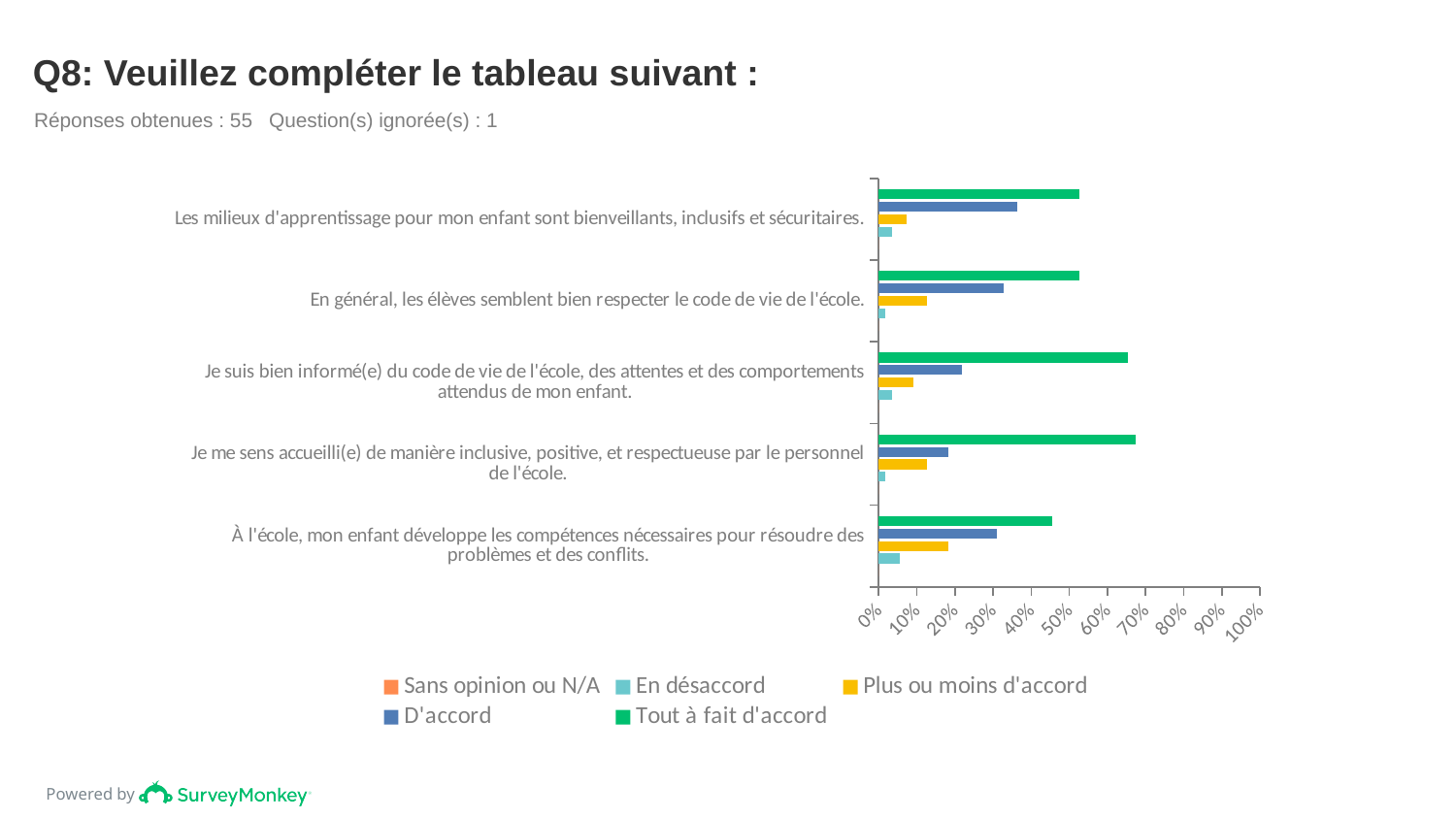
For 'Je me sens accueilli(e) de manière inclusive, positive, et respectueuse par le personnel de l'école.', which is larger: 'Tout à fait d'accord' or 'D'accord'? Tout à fait d'accord Which statement has the highest value for 'Plus ou moins d'accord'? À l'école, mon enfant développe les compétences nécessaires pour résoudre des problèmes et des conflits. Is the 'Plus ou moins d'accord' value for 'À l'école, mon enfant développe les compétences nécessaires pour résoudre des problèmes et des conflits.' greater or less than 10%? greater Is the 'Tout à fait d'accord' value for 'À l'école, mon enfant développe les compétences nécessaires pour résoudre des problèmes et des conflits.' greater or less than 50%? less Which statement has the larger 'Plus ou moins d'accord' value: 'Les milieux d'apprentissage pour mon enfant sont bienveillants, inclusifs et sécuritaires.' or 'À l'école, mon enfant développe les compétences nécessaires pour résoudre des problèmes et des conflits.'? À l'école, mon enfant développe les compétences nécessaires pour résoudre des problèmes et des conflits. How many statements (categories) are plotted on the chart? 5 What kind of chart is shown on the slide? Bar chart Is the 'D'accord' value for 'Les milieux d'apprentissage pour mon enfant sont bienveillants, inclusifs et sécuritaires.' greater or less than 30%? greater Which statement has the lowest value for 'Tout à fait d'accord'? À l'école, mon enfant développe les compétences nécessaires pour résoudre des problèmes et des conflits. How many responses were obtained for this question according to the slide? 55 How many series does the legend list? 5